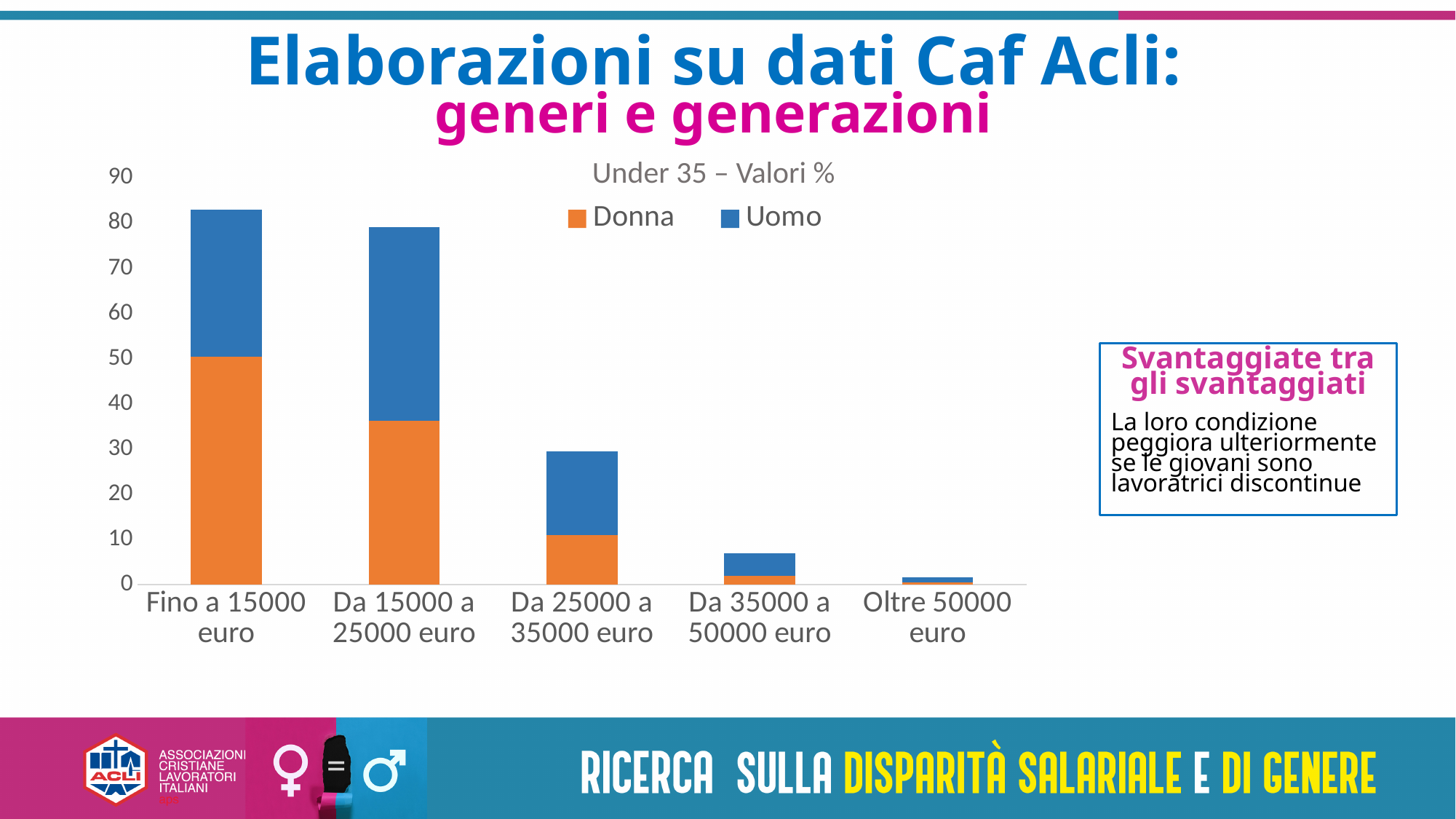
Is the total stacked value for 'Da 25000 a 35000 euro' greater or less than 40? less Is the Donna value for 'Fino a 15000 euro' greater or less than 40? greater How many series does the chart legend list? 2 Which has the larger Donna value: 'Fino a 15000 euro' or 'Da 15000 a 25000 euro'? Fino a 15000 euro How many income categories are shown on the x axis of the chart? 5 What is the title of the chart? Under 35 – Valori % Do the stacked bar totals rise or fall as income categories increase along the x axis? Fall Which income category has the shortest stacked bar? Oltre 50000 euro Is the Donna value for 'Da 15000 a 25000 euro' greater or less than 30? greater What kind of chart is shown on the slide? Stacked bar chart Which series is shown in orange in the chart? Donna Which income category has the tallest stacked bar? Fino a 15000 euro